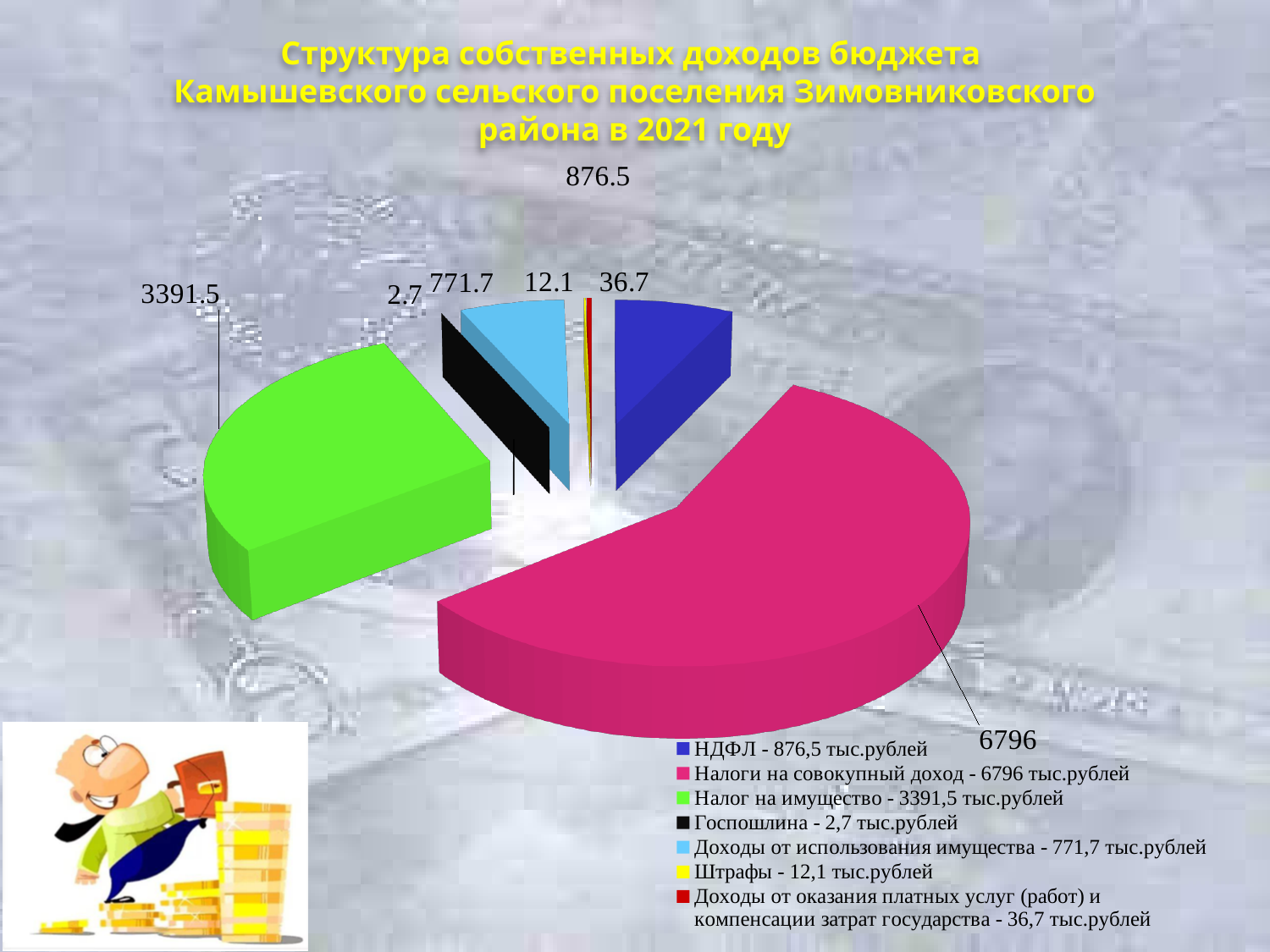
How many entries does the legend list? 7 What colour is the slice for Налог на имущество? green How many slices does the pie chart have? 7 What is the value for Налог на имущество? 3391.5 Which category has the largest value? Налоги на совокупный доход What is the value for Доходы от использования имущества? 771.7 What is the value for Налоги на совокупный доход? 6796 Which category has the smallest value? Госпошлина What is the difference between Налоги на совокупный доход and Налог на имущество? 3404.5 Which is larger, НДФЛ or Доходы от использования имущества? НДФЛ What is the value for НДФЛ? 876.5 What type of chart is shown on the slide? pie chart